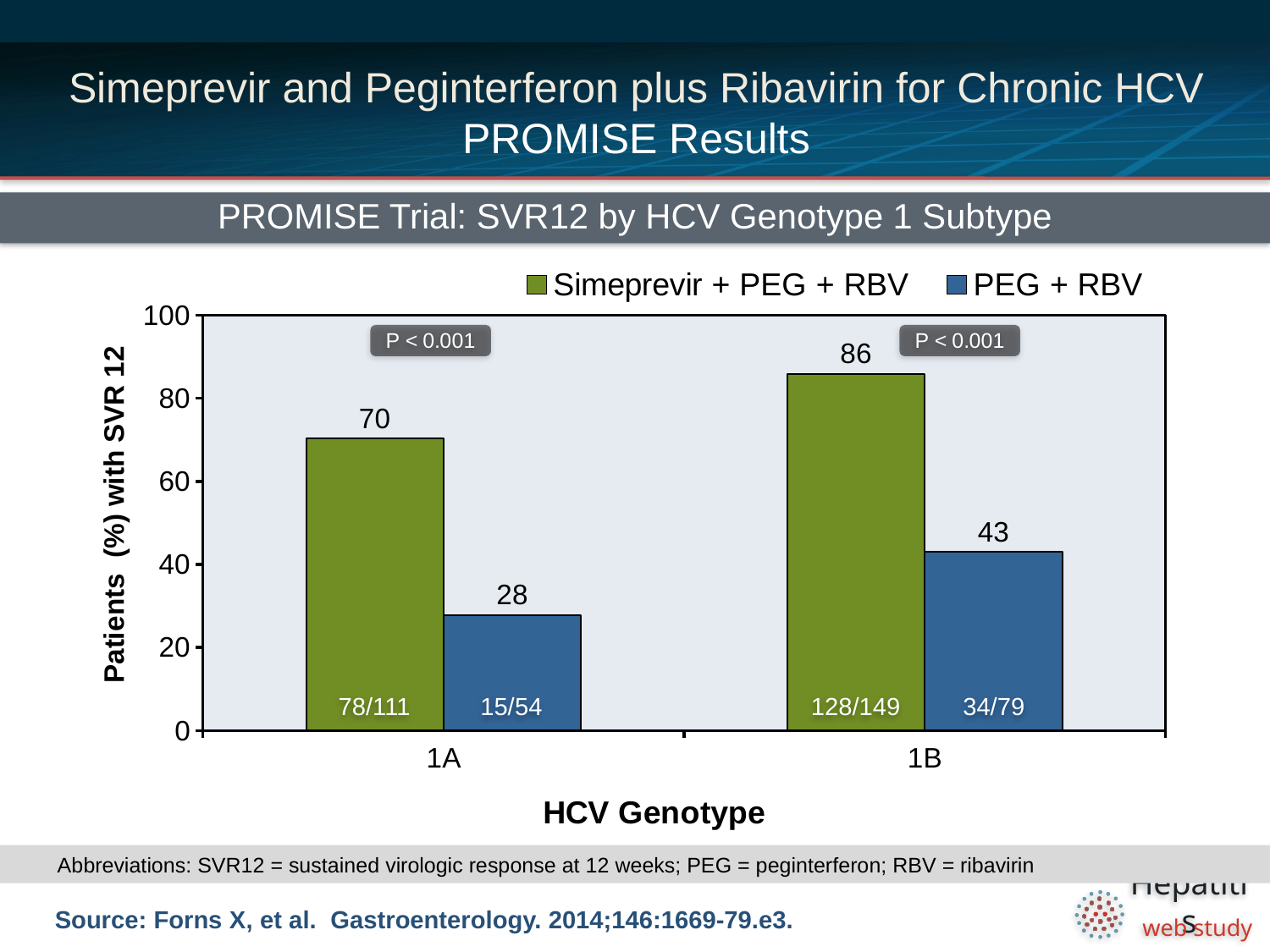
What is the difference in SVR12 rate between Simeprevir + PEG + RBV and PEG + RBV for genotype 1B? 43 What is the difference in SVR12 rate between Simeprevir + PEG + RBV and PEG + RBV for genotype 1A? 42 How many series does the legend list? 2 What is the SVR12 rate for PEG + RBV in genotype 1A? 28 How many HCV genotype categories are shown on the x axis? 2 Which is larger: the Simeprevir + PEG + RBV rate for 1A or the PEG + RBV rate for 1B? Simeprevir + PEG + RBV for 1A What is the SVR12 rate for Simeprevir + PEG + RBV in genotype 1A? 70 Which bar has the highest SVR12 rate on the chart? Simeprevir + PEG + RBV, 1B What kind of chart is shown on the slide? Bar chart What fraction of patients is printed inside the Simeprevir + PEG + RBV bar for genotype 1B? 128/149 What is the SVR12 rate for PEG + RBV in genotype 1B? 43 Which bar has the lowest SVR12 rate on the chart? PEG + RBV, 1A